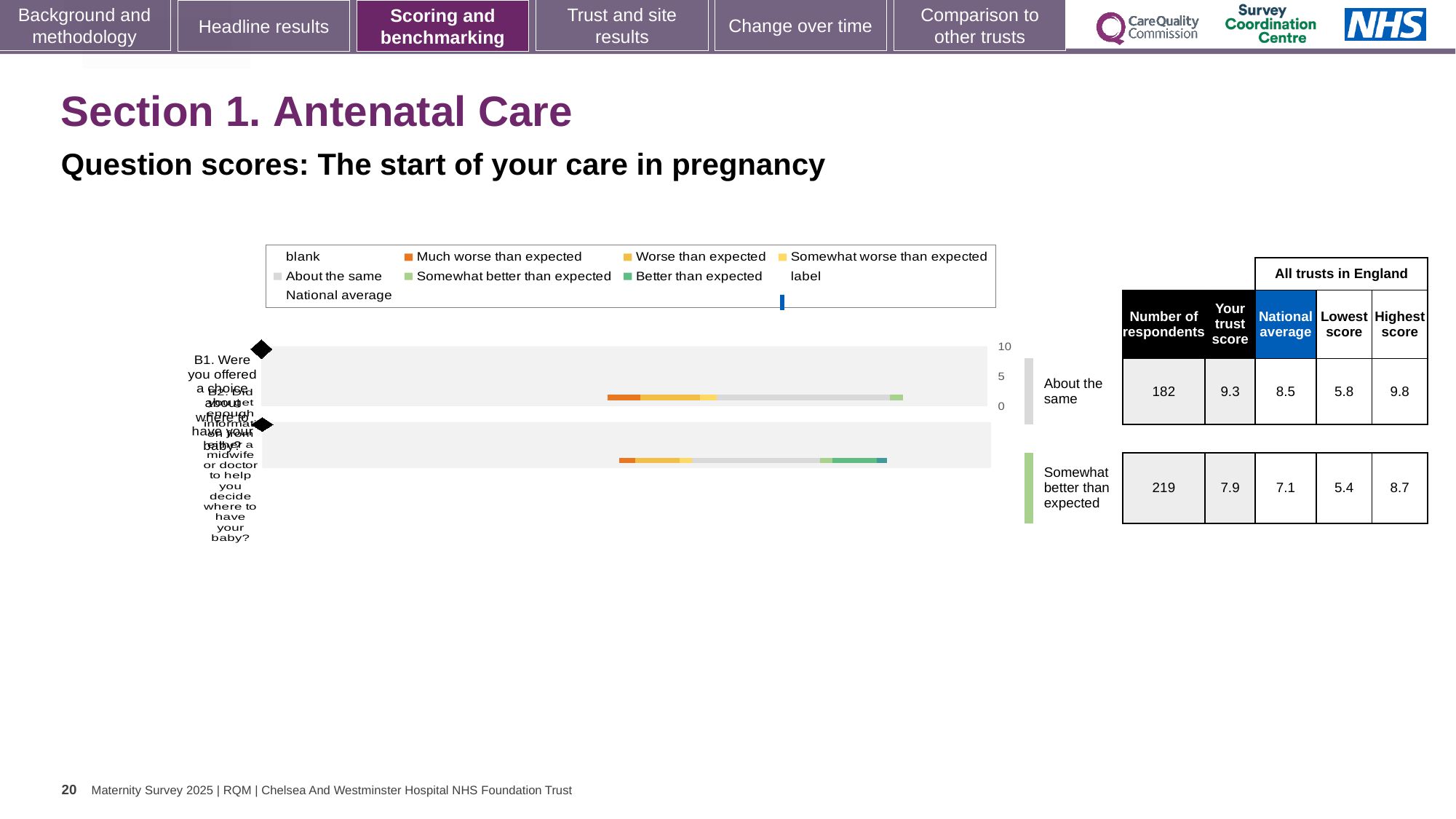
Which colour does the legend use for 'Much worse than expected'? orange In the table beside the chart, what is the national average for question B2 (Somewhat better than expected)? 7.1 How many question bars are plotted in the chart? 2 In the table beside the chart, what is the highest score across all trusts in England for question B1? 9.8 In the table beside the chart, which question has the higher trust score, B1 or B2? B1 What kind of chart is shown on the slide? bar chart In the table beside the chart, what is the trust score for question B1 (About the same)? 9.3 In the table beside the chart, what is the difference between the trust score and the national average for question B1? 0.8 What is the highest value shown on the chart's axis? 10 In the table beside the chart, what is the lowest score across all trusts in England for question B2? 5.4 In the table beside the chart, which question has more respondents, B1 or B2? B2 In the table beside the chart, what is the number of respondents for question B1 (About the same)? 182